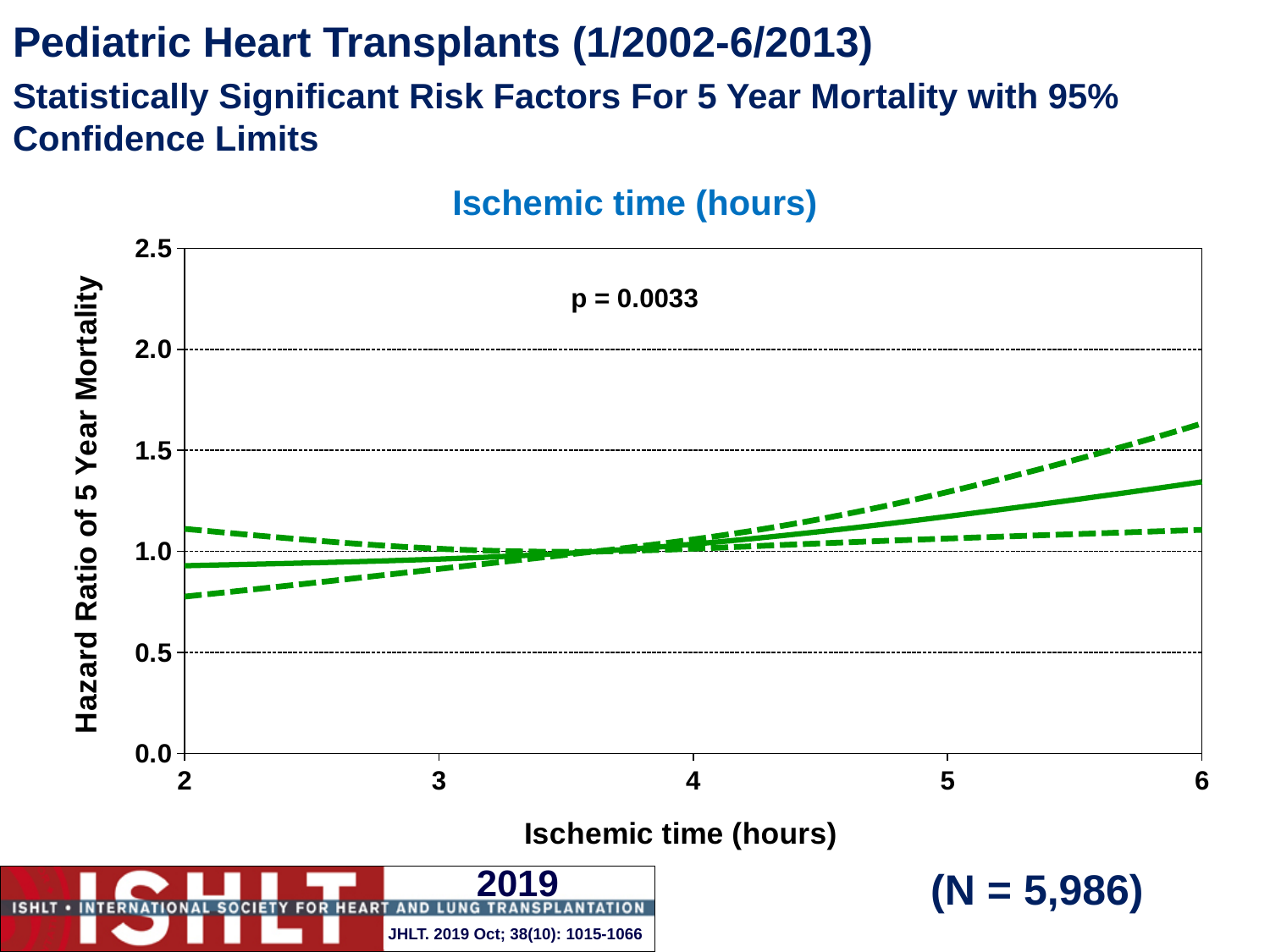
Is the upper 95% confidence limit (upper dashed line) at 6 hours greater or less than 1.5? greater What is the sample size (N) shown on the slide? N = 5,986 What kind of chart is shown on the slide? Line chart What is the highest value shown on the y axis? 2.5 Is the lower 95% confidence limit (lower dashed line) at 2 hours greater or less than 1.0? less What is the title of the y axis? Hazard Ratio of 5 Year Mortality Is the hazard ratio (solid line) at 6 hours greater or less than 1.5? less How many lines are plotted on the chart? 3 What is the p-value shown on the chart? p = 0.0033 Does the solid hazard ratio line rise or fall as ischemic time increases from 2 to 6 hours? Rises